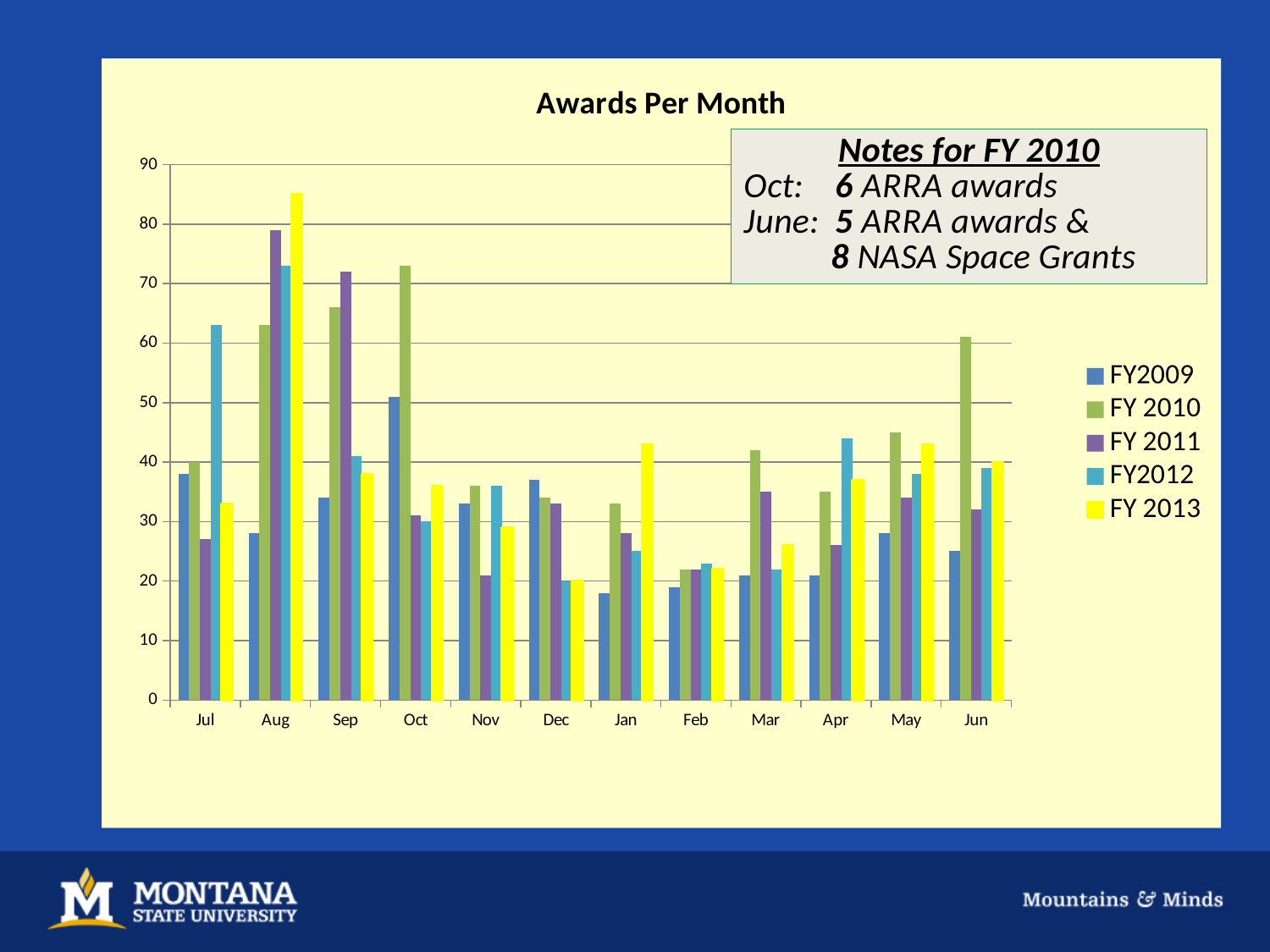
Which series has the tallest bar in Aug? FY 2013 How many months are shown on the x axis? 12 In Oct, which is larger: FY2009 or FY 2010? FY 2010 What is the title of the chart? Awards Per Month How many series does the legend list? 5 In which month is the FY 2013 bar highest? Aug What kind of chart is shown on the slide? bar chart In which month is the FY 2010 bar lowest? Feb Is the value for FY2012 in Jul greater or less than 60? greater Is the value for FY 2013 in Aug greater or less than 80? greater Which series is shown in yellow? FY 2013 Is the value for FY2012 in Dec greater or less than 30? less